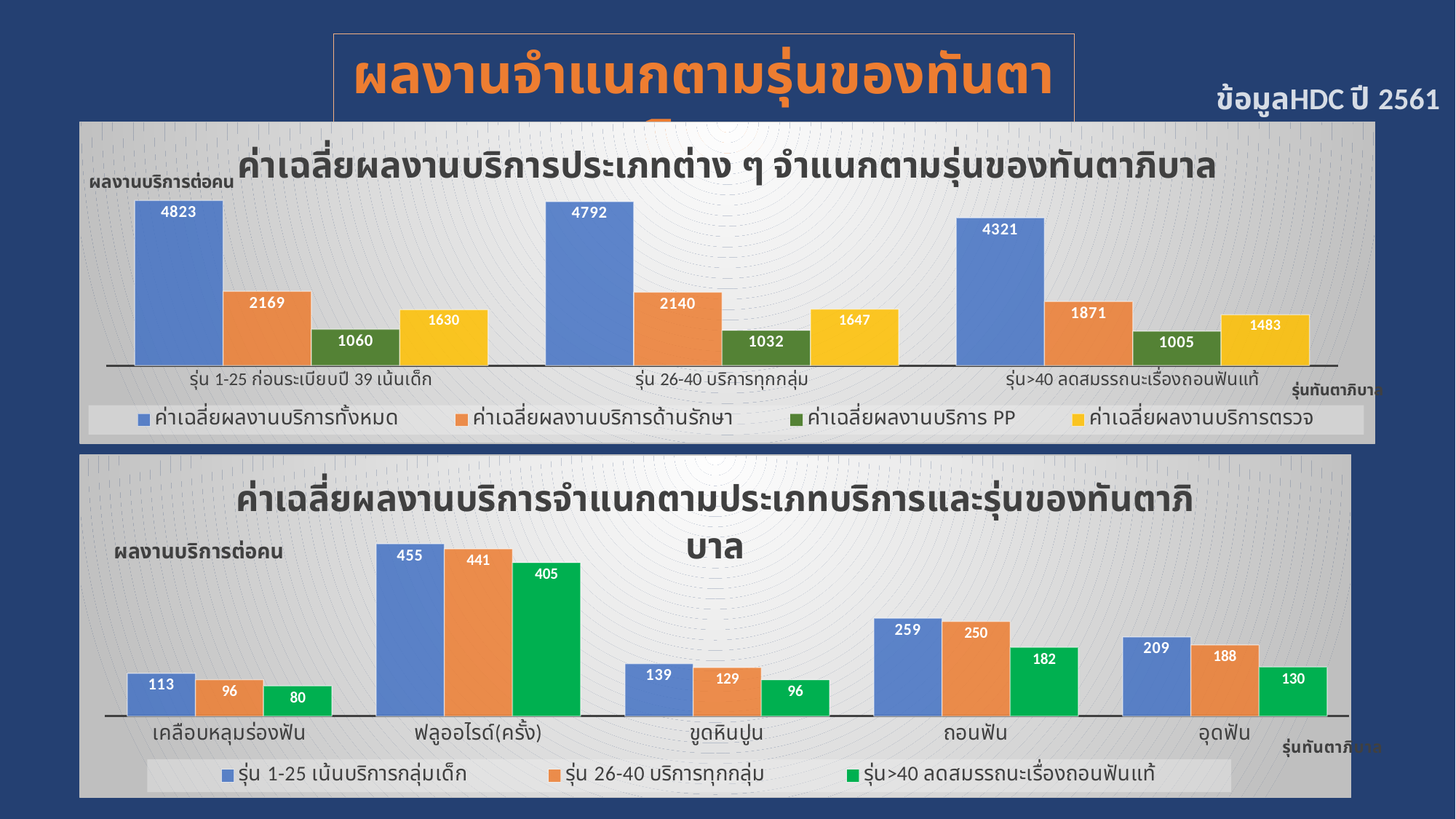
In the bottom chart, what is the value for ฟลูออไรด์(ครั้ง) for รุ่น 26-40? 441 In the top chart, what is the value of ค่าเฉลี่ยผลงานบริการทั้งหมด for รุ่น 1-25? 4823 In the bottom chart, what is the difference between รุ่น 1-25 and รุ่น>40 for ถอนฟัน? 77 In the bottom chart, which service type has the highest value for รุ่น 1-25? ฟลูออไรด์(ครั้ง) What type of chart is the bottom chart? Bar chart In the top chart, what is the difference between ค่าเฉลี่ยผลงานบริการด้านรักษา for รุ่น 1-25 and for รุ่น>40? 298 In the top chart, which generation group has the lowest ค่าเฉลี่ยผลงานบริการทั้งหมด? รุ่น>40 ลดสมรรถนะเรื่องถอนฟันแท้ In the bottom chart, which service type has the lowest value for รุ่น>40? เคลือบหลุมร่องฟัน In the top chart, is ค่าเฉลี่ยผลงานบริการตรวจ higher for รุ่น 1-25 or for รุ่น 26-40? รุ่น 26-40 In the bottom chart, how many service categories are shown on the x axis? 5 In the top chart, what is the value of ค่าเฉลี่ยผลงานบริการ PP for รุ่น 26-40? 1032 In the top chart, how many series does the legend list? 4